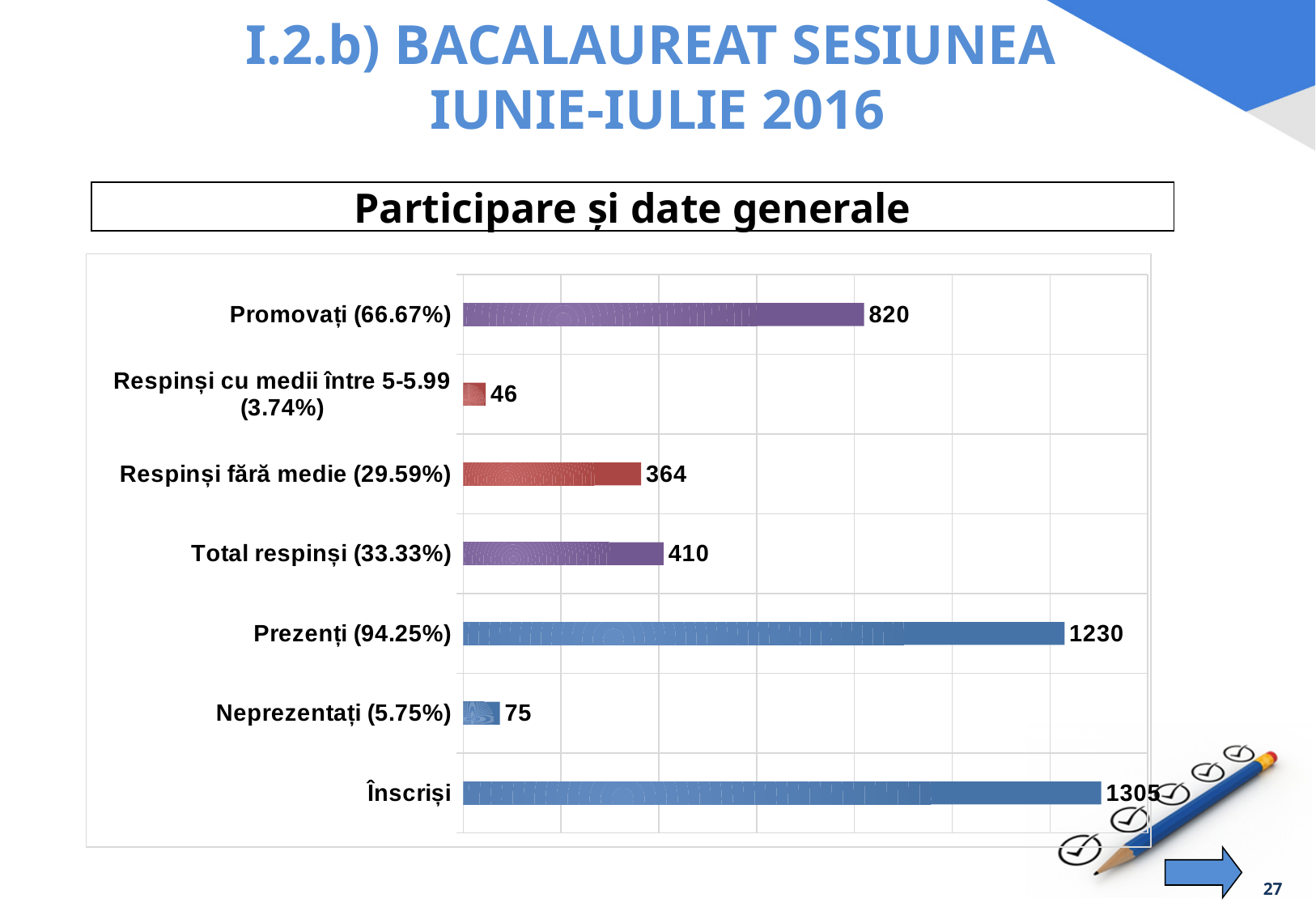
Which category has the highest value? Înscriși What kind of chart is shown on the slide? bar chart Which category has the lowest value? Respinși cu medii între 5-5.99 (3.74%) What is the value for Înscriși? 1305 What is the value for Respinși cu medii între 5-5.99 (3.74%)? 46 What is the difference between the values for Înscriși and Prezenți (94.25%)? 75 What is the title shown above the chart? Participare și date generale Which is larger, the value for Promovați (66.67%) or the value for Total respinși (33.33%)? Promovați (66.67%) How many categories are shown in the chart? 7 What is the value for Promovați (66.67%)? 820 What is the difference between the values for Total respinși (33.33%) and Respinși fără medie (29.59%)? 46 What is the value for Prezenți (94.25%)? 1230